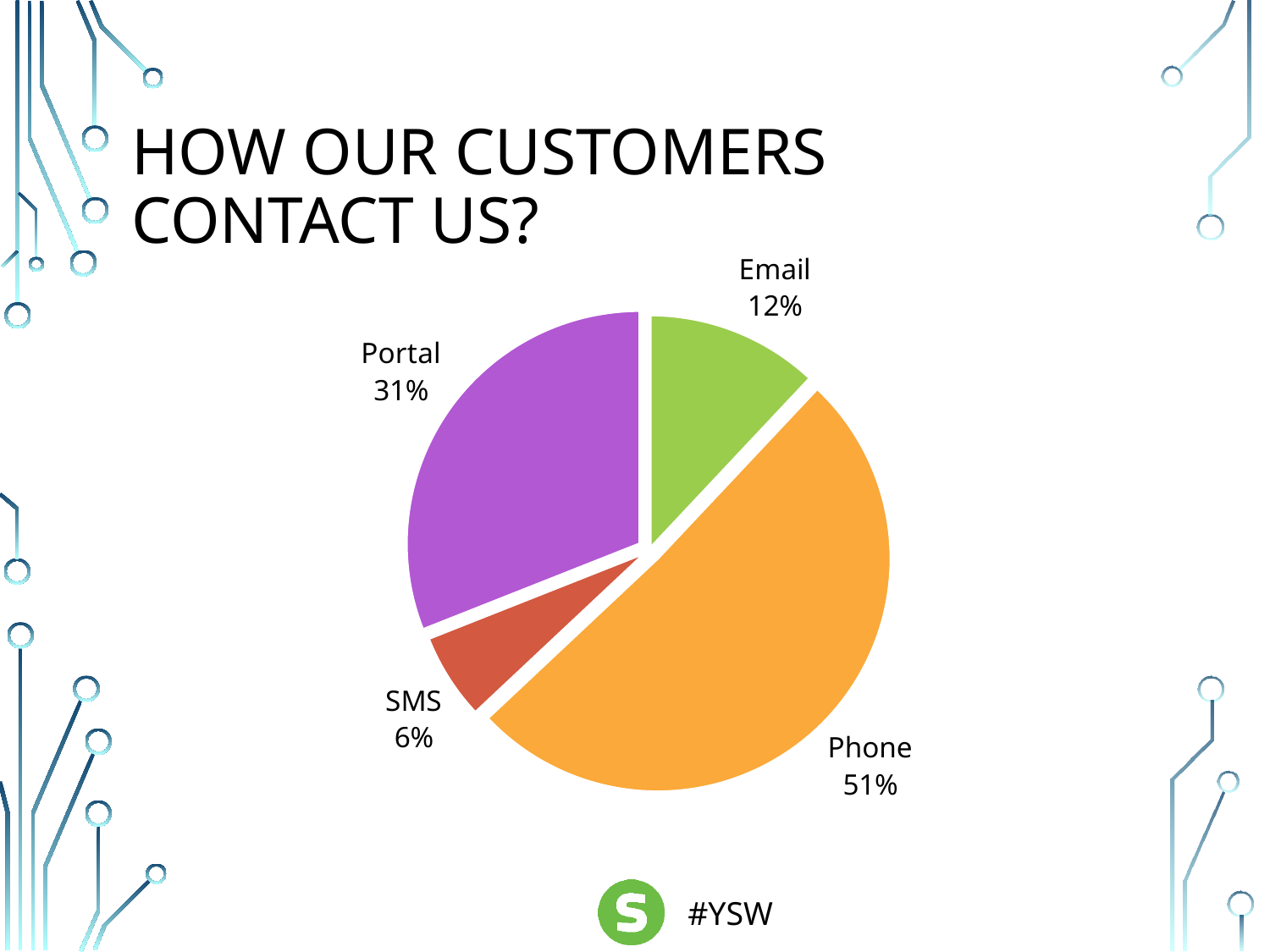
What is the difference in percentage points between Phone and Portal? 20 Which is larger, the share for Email or the share for SMS? Email What colour is the Phone slice of the pie chart? orange What type of chart is shown on the slide? pie chart What percentage of customers contact us by Phone? 51% Which contact method has the smallest share? SMS What percentage of customers contact us by SMS? 6% How many contact methods are shown in the pie chart? 4 What percentage of customers contact us via the Portal? 31% What percentage of customers contact us by Email? 12% Which contact method has the largest share? Phone What is the title of the slide containing the pie chart? HOW OUR CUSTOMERS CONTACT US?